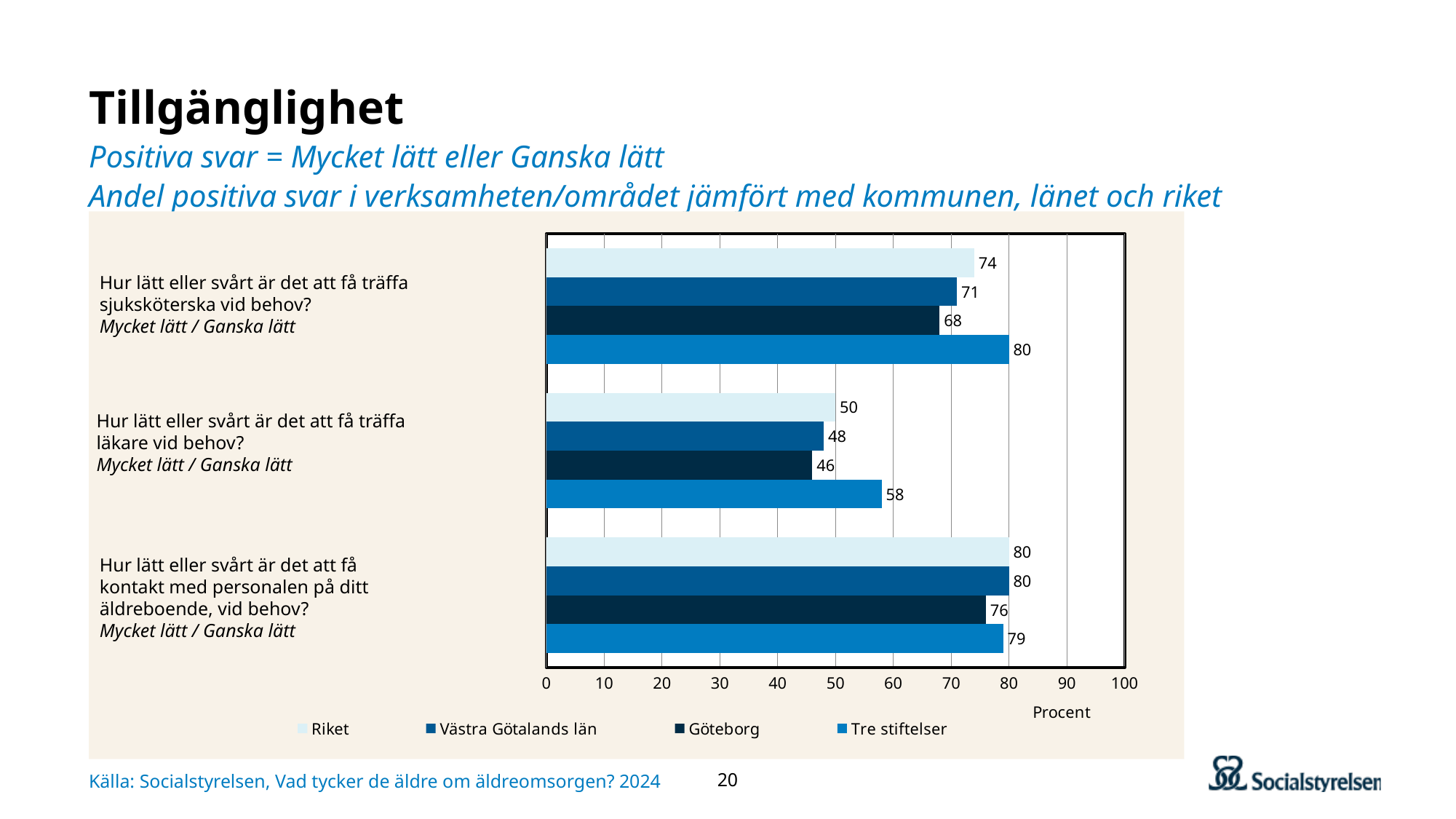
What is the label on the horizontal axis of the chart? Procent What is the value for Göteborg on the question about meeting a doctor (läkare) when needed? 46 Which series has the highest value on the question about meeting a doctor (läkare) when needed? Tre stiftelser How many series does the legend list? 4 What is the value for Tre stiftelser on the question about meeting a nurse (sjuksköterska) when needed? 80 What type of chart is shown on the slide? bar chart Which series has the lowest value on the question about meeting a nurse (sjuksköterska) when needed? Göteborg How many question categories are plotted on the chart? 3 Is the value for Göteborg on the question about meeting a doctor (läkare) greater or less than 50? less What is the difference between Tre stiftelser and Riket on the question about meeting a doctor (läkare) when needed? 8 On the question about meeting a nurse (sjuksköterska), which is larger: Riket or Västra Götalands län? Riket What is the value for Riket on the question about getting in contact with staff at the äldreboende? 80